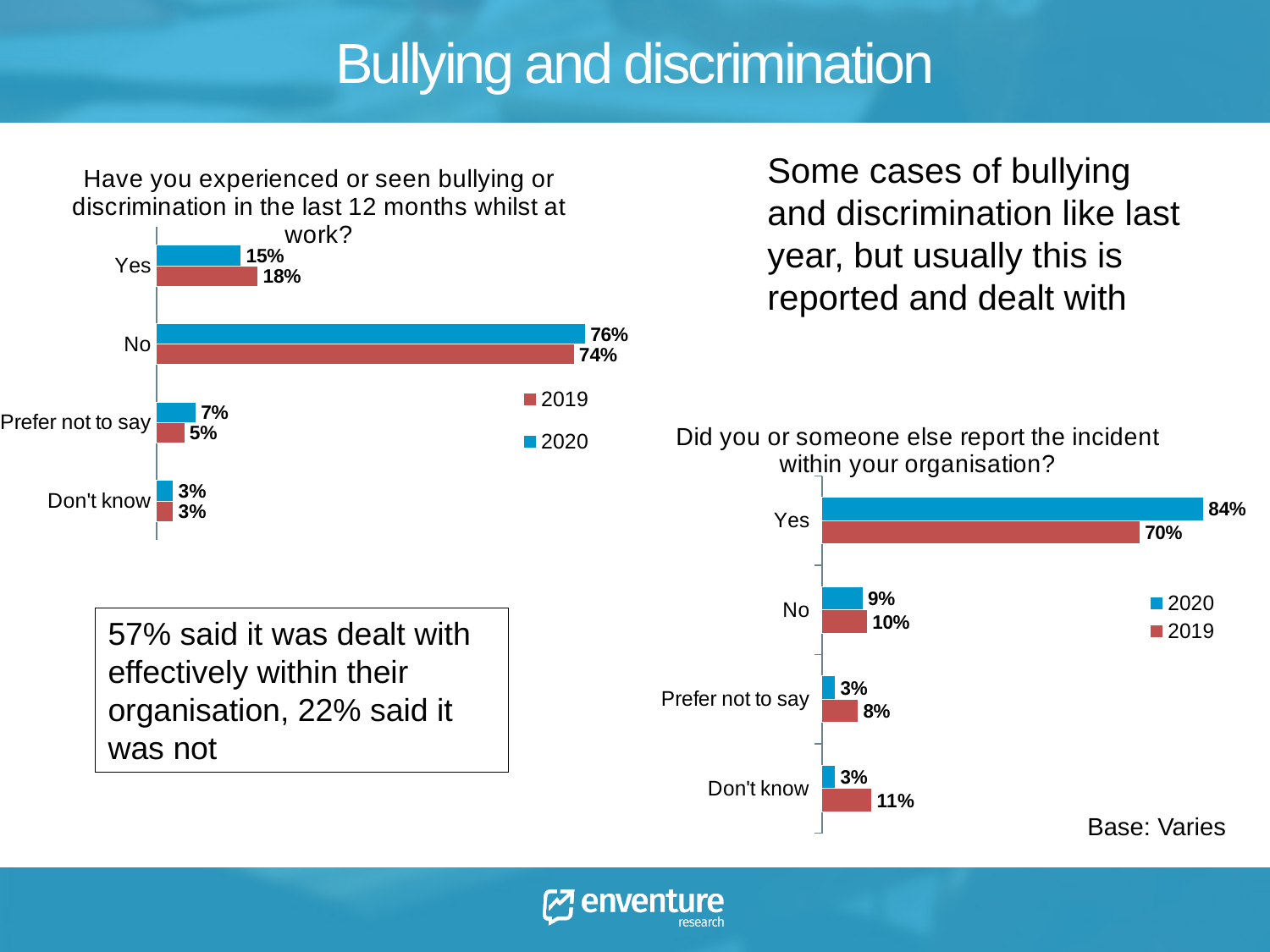
In the chart 'Did you or someone else report the incident within your organisation?', what is the 2019 value for 'Don't know'? 11% In the chart 'Have you experienced or seen bullying or discrimination in the last 12 months whilst at work?', what is the 2020 value for 'No'? 76% What type of chart is 'Did you or someone else report the incident within your organisation?'? Bar chart In the chart 'Did you or someone else report the incident within your organisation?', which category has the lowest 2019 value? Prefer not to say In the chart 'Have you experienced or seen bullying or discrimination in the last 12 months whilst at work?', what is the 2019 value for 'Yes'? 18% In the chart 'Did you or someone else report the incident within your organisation?', what is the 2020 value for 'Yes'? 84% How many series does the legend list in the chart 'Did you or someone else report the incident within your organisation?'? 2 In the chart 'Have you experienced or seen bullying or discrimination in the last 12 months whilst at work?', how many categories are shown? 4 In the chart 'Did you or someone else report the incident within your organisation?', what is the difference between the 2020 and 2019 values for 'Yes'? 14% In the chart 'Did you or someone else report the incident within your organisation?', which is larger for 'Prefer not to say': the 2020 value or the 2019 value? 2019 In the chart 'Have you experienced or seen bullying or discrimination in the last 12 months whilst at work?', what is the difference between the 2020 and 2019 values for 'Yes'? 3% In the chart 'Have you experienced or seen bullying or discrimination in the last 12 months whilst at work?', which category has the highest 2020 value? No